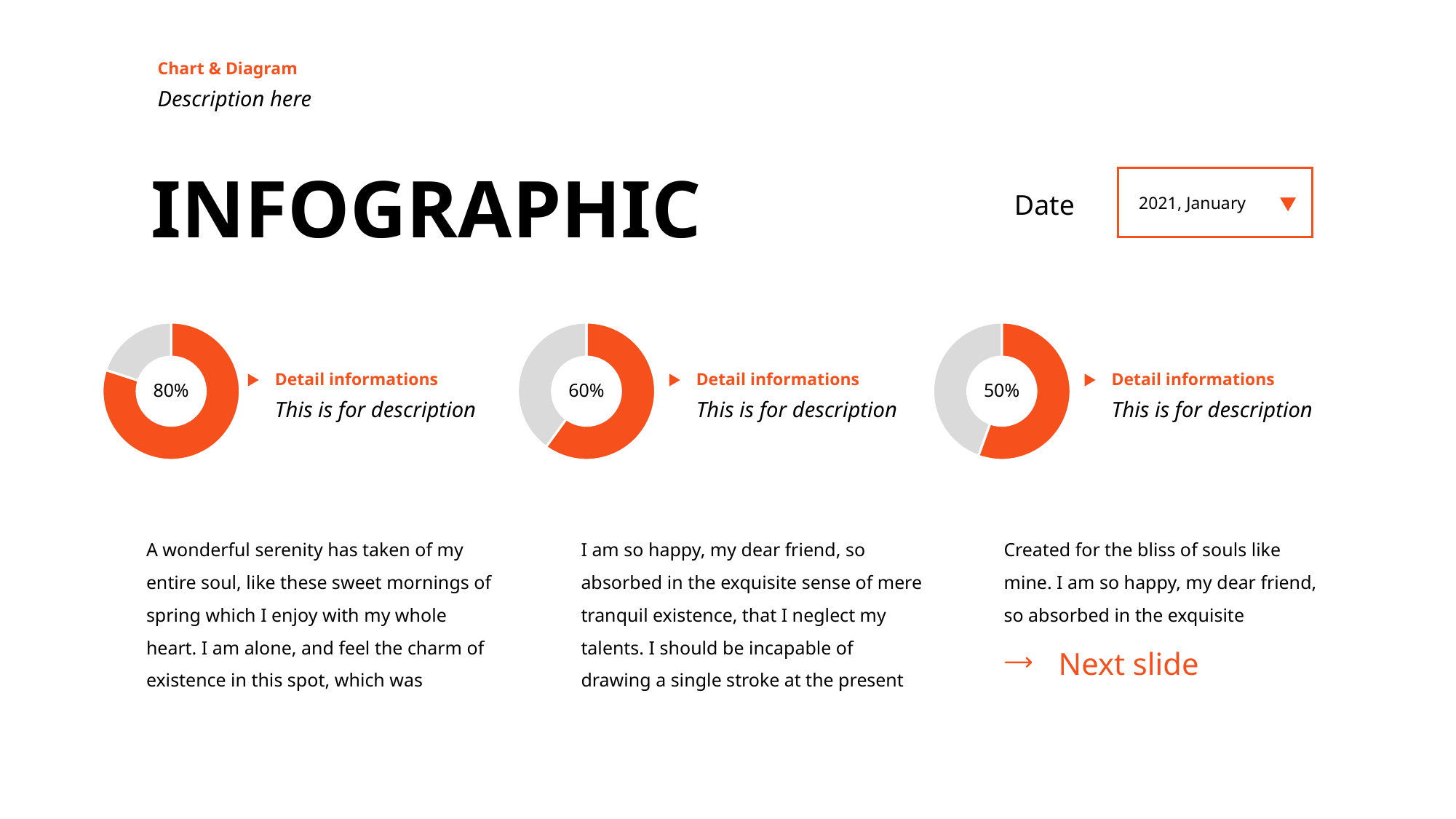
What percentage is shown in the centre of the left donut chart? 80% How many donut charts are shown on the slide? 3 What percentage is shown in the centre of the right donut chart? 50% What label appears in bold orange text next to each donut chart? Detail informations What is the difference between the percentage in the middle donut chart and the percentage in the right donut chart? 10% What is the difference between the percentage in the left donut chart and the percentage in the right donut chart? 30% Which is larger, the percentage in the left donut chart or the percentage in the middle donut chart? The left chart (80%) Which of the three donut charts shows the highest percentage? The left chart (80%) What colour is the filled (highlighted) portion of each donut chart? Orange Which of the three donut charts shows the lowest percentage? The right chart (50%) What kind of chart is used for each of the three charts on the slide? Donut chart What percentage is shown in the centre of the middle donut chart? 60%